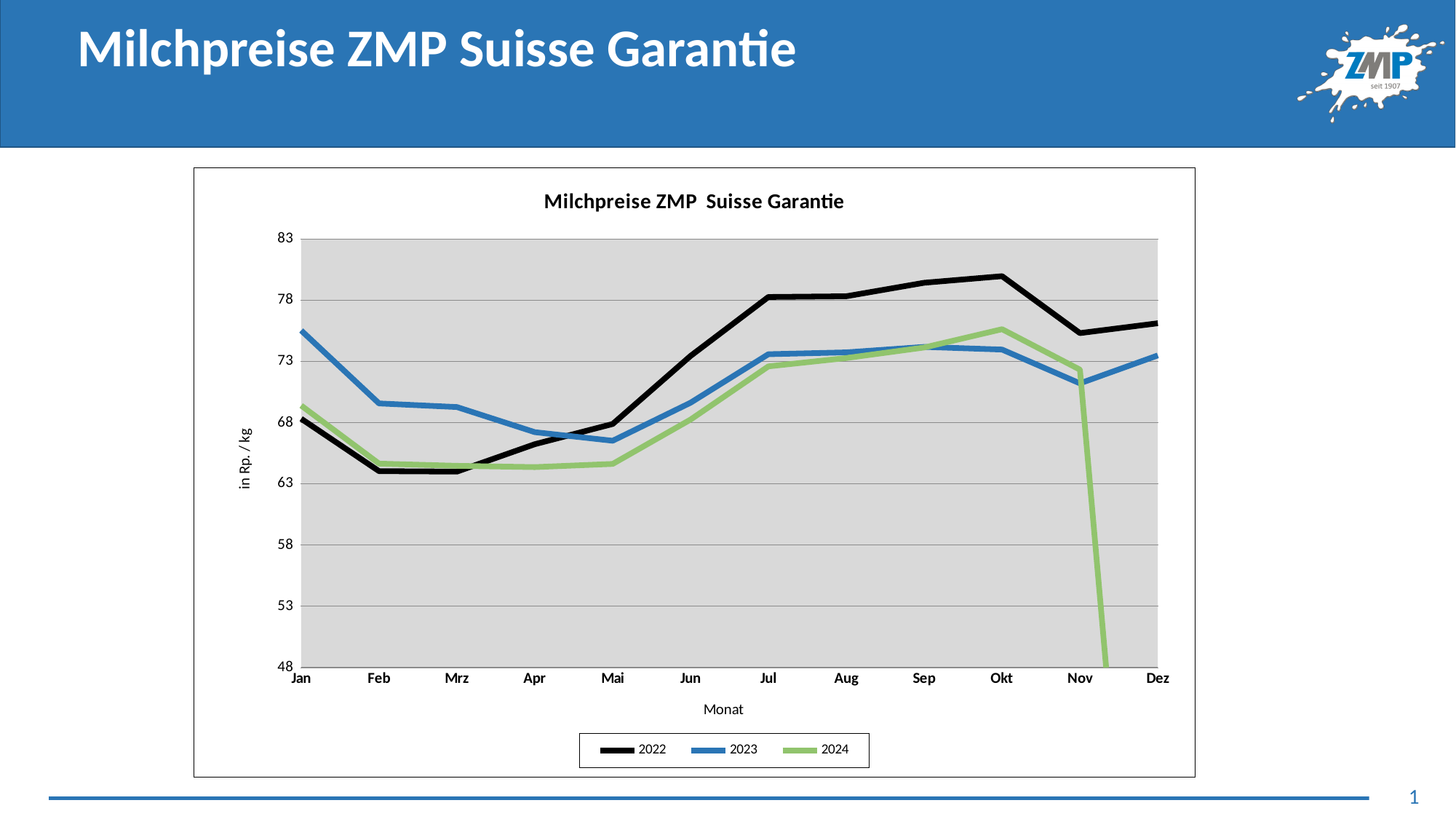
In Jan, which series has the higher value, 2022 or 2023? 2023 In which month does the 2022 line reach its highest value? Okt In which month does the 2024 line reach its highest value? Okt Is the value for 2023 in Jan greater or less than 73? greater Which series are listed in the legend? 2022, 2023, 2024 What kind of chart is shown on the slide? line chart Is the value for 2022 in Okt greater or less than 78? greater Is the value for 2023 in Mai greater or less than 68? less How many series does the legend list? 3 How many months are shown on the x axis? 12 What is the label of the y axis? in Rp. / kg Does the 2022 line rise or fall from Mrz to Okt? rise